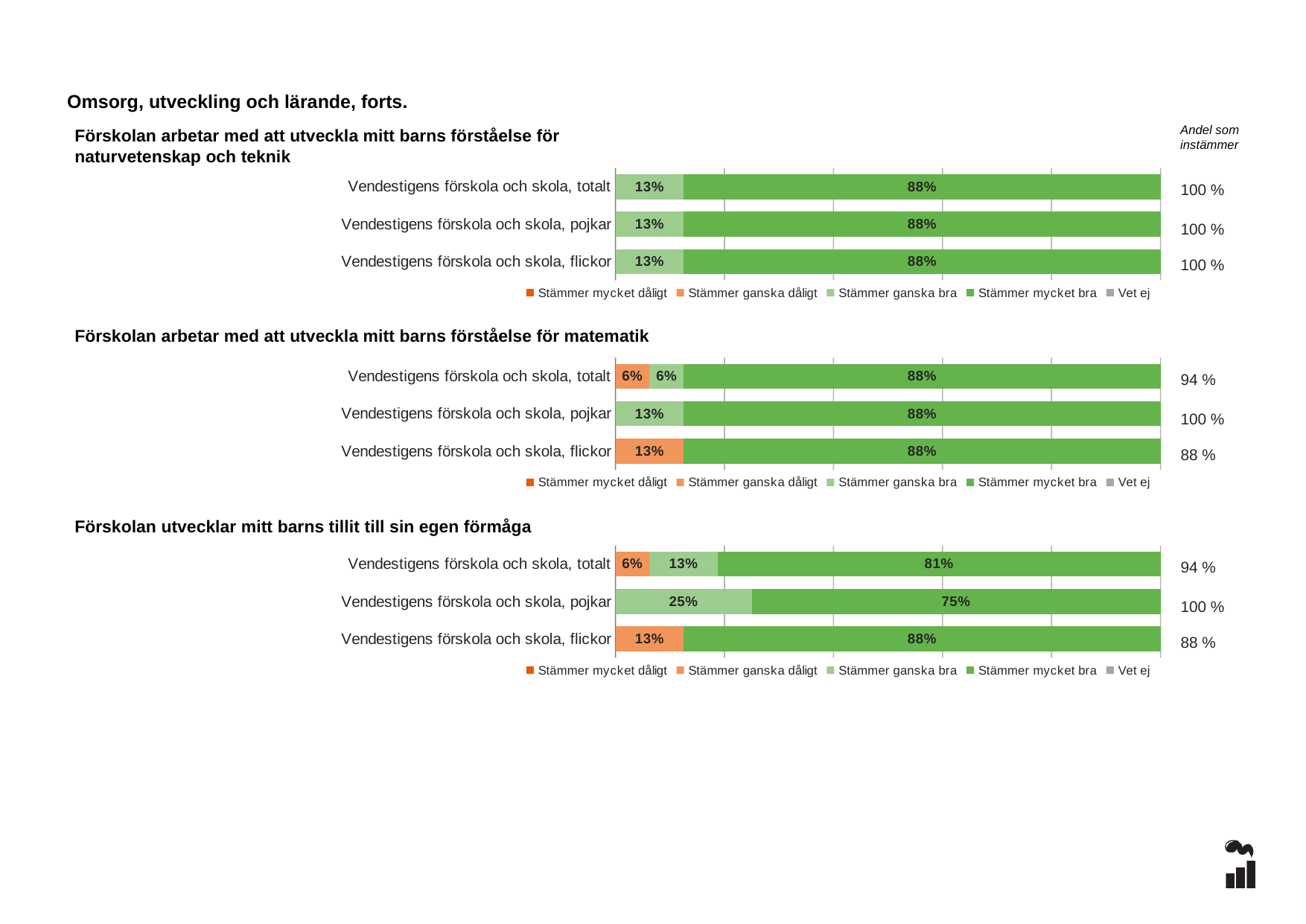
In the chart 'Förskolan utvecklar mitt barns tillit till sin egen förmåga', what is the difference between the 'Stämmer mycket bra' values for 'Vendestigens förskola och skola, flickor' and 'Vendestigens förskola och skola, totalt'? 7% In the chart 'Förskolan arbetar med att utveckla mitt barns förståelse för matematik', what is the 'Andel som instämmer' value for 'Vendestigens förskola och skola, flickor'? 88 % How many categories are shown in the chart 'Förskolan arbetar med att utveckla mitt barns förståelse för matematik'? 3 In the chart 'Förskolan utvecklar mitt barns tillit till sin egen förmåga', which is larger: the 'Stämmer ganska bra' value for 'Vendestigens förskola och skola, pojkar' or for 'Vendestigens förskola och skola, totalt'? Vendestigens förskola och skola, pojkar In the chart 'Förskolan utvecklar mitt barns tillit till sin egen förmåga', what is the 'Stämmer mycket bra' value for 'Vendestigens förskola och skola, pojkar'? 75% How many series does the legend list for the chart 'Förskolan utvecklar mitt barns tillit till sin egen förmåga'? 5 In the chart 'Förskolan arbetar med att utveckla mitt barns förståelse för matematik', what is the 'Stämmer ganska dåligt' value for 'Vendestigens förskola och skola, totalt'? 6% In the chart 'Förskolan arbetar med att utveckla mitt barns förståelse för naturvetenskap och teknik', what is the 'Stämmer ganska bra' value for 'Vendestigens förskola och skola, flickor'? 13% In the chart 'Förskolan arbetar med att utveckla mitt barns förståelse för naturvetenskap och teknik', what is the 'Stämmer mycket bra' value for 'Vendestigens förskola och skola, totalt'? 88% In the chart 'Förskolan arbetar med att utveckla mitt barns förståelse för matematik', what is the total of the 'Stämmer ganska bra' and 'Stämmer mycket bra' segments for 'Vendestigens förskola och skola, pojkar'? 101% What kind of chart is 'Förskolan arbetar med att utveckla mitt barns förståelse för naturvetenskap och teknik'? Stacked bar chart In the chart 'Förskolan utvecklar mitt barns tillit till sin egen förmåga', which category has the lowest 'Stämmer mycket bra' value? Vendestigens förskola och skola, pojkar